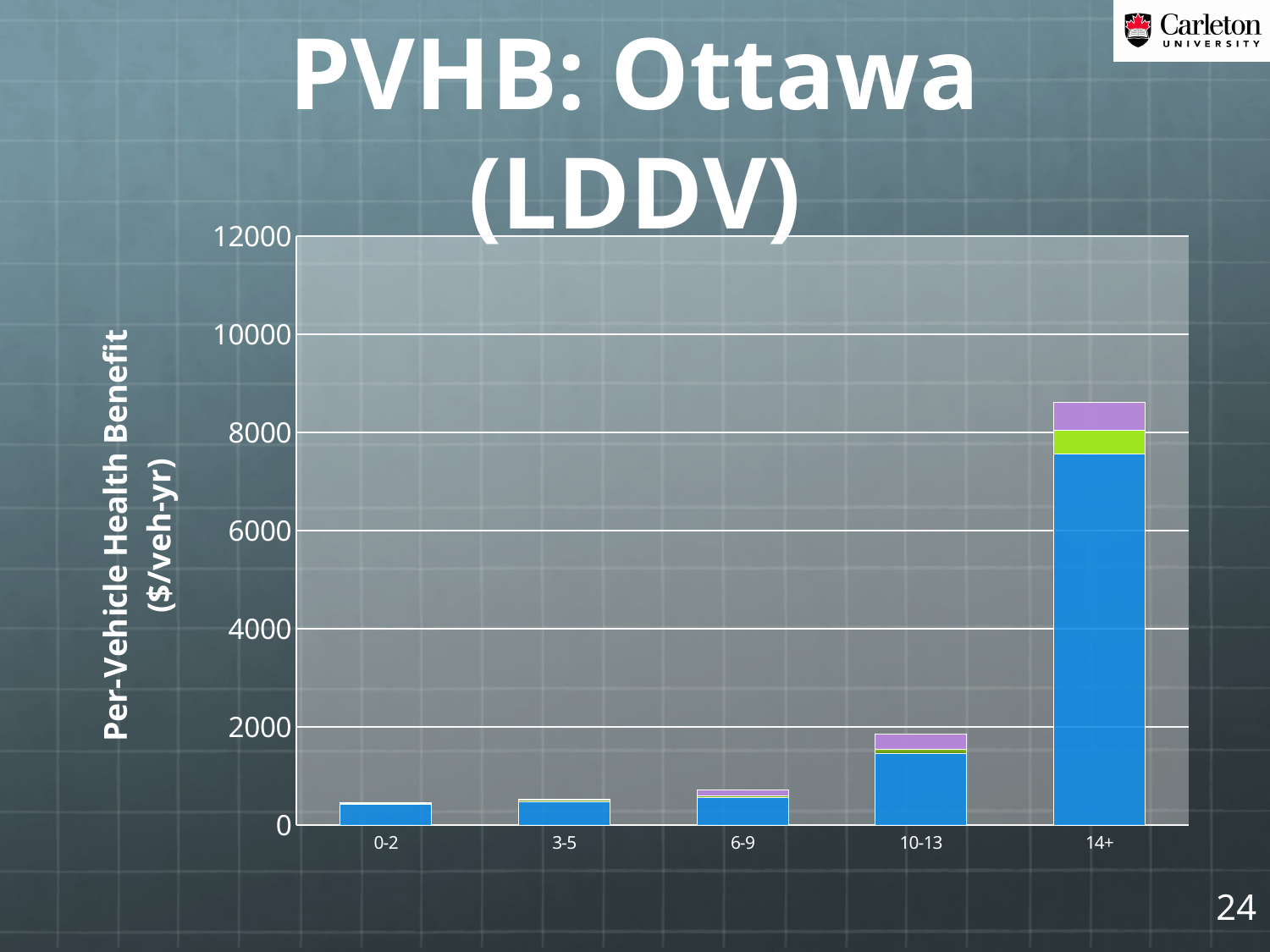
Do the bar totals rise or fall moving from the 0-2 category to the 14+ category? rise Which category has the highest total per-vehicle health benefit? 14+ What is the title of the chart on the slide? PVHB: Ottawa (LDDV) Is the total value for the 6-9 category greater or less than 4000? less Which has a larger total value, the 6-9 category or the 10-13 category? 10-13 What type of chart is shown on the slide? stacked bar chart What is the label of the vertical axis? Per-Vehicle Health Benefit ($/veh-yr) Which has a larger total value, the 10-13 category or the 14+ category? 14+ Is the total value for the 14+ category greater or less than 8000? greater Is the total value for the 0-2 category greater or less than 2000? less How many vehicle age categories are shown on the x axis? 5